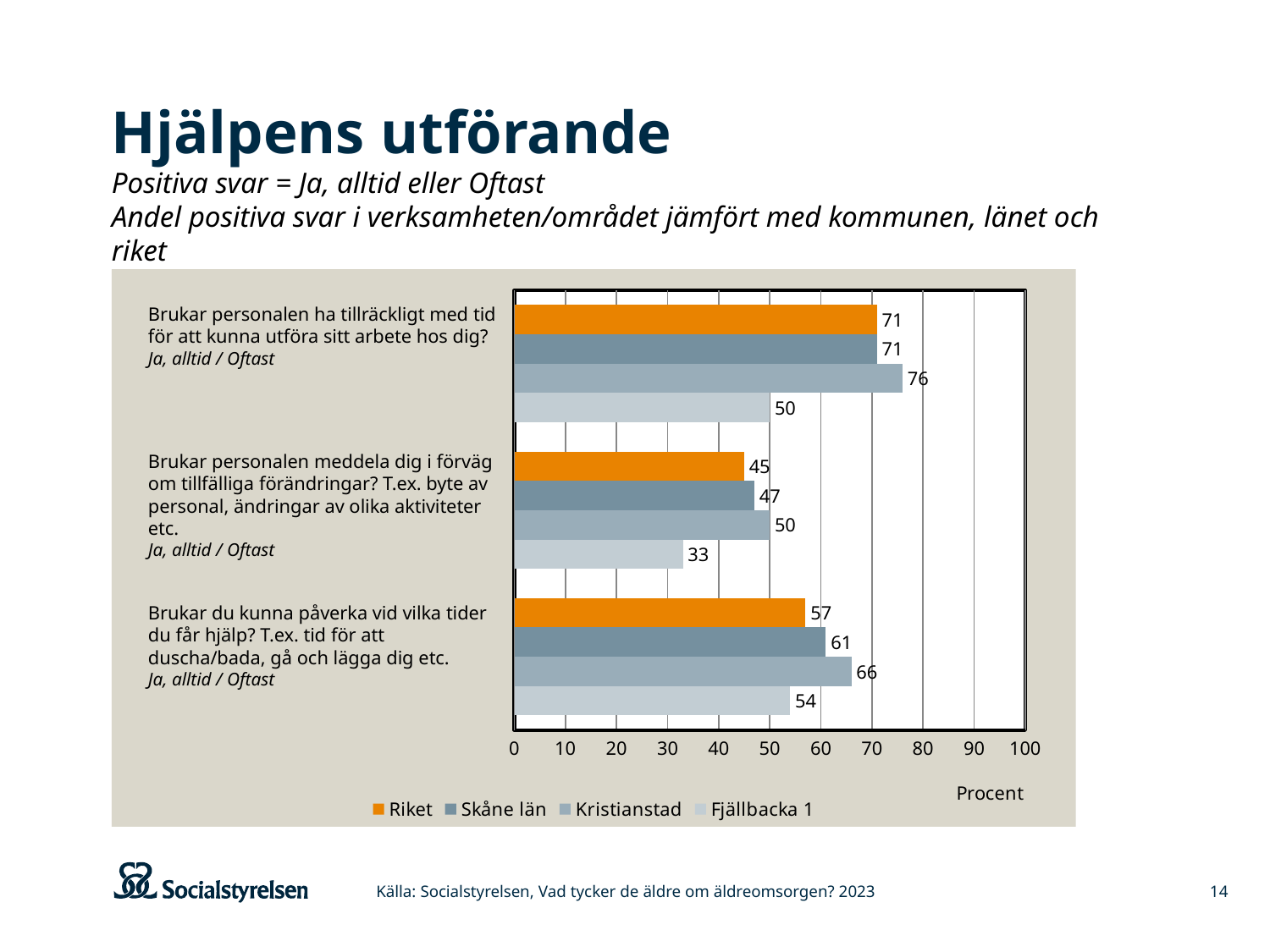
Which series has the lowest value for the question "Brukar personalen meddela dig i förväg om tillfälliga förändringar?"? Fjällbacka 1 How many question categories are shown on the chart? 3 Which is larger for the question "Brukar du kunna påverka vid vilka tider du får hjälp?": Skåne län or Fjällbacka 1? Skåne län How many series does the legend list? 4 What is the difference between Kristianstad and Fjällbacka 1 for the question "Brukar personalen ha tillräckligt med tid för att kunna utföra sitt arbete hos dig?"? 26 Is the value for Fjällbacka 1 for the question "Brukar personalen meddela dig i förväg om tillfälliga förändringar?" greater or less than 40? less Which series has the highest value for the question "Brukar personalen ha tillräckligt med tid för att kunna utföra sitt arbete hos dig?"? Kristianstad What is the value for Fjällbacka 1 for the question "Brukar personalen ha tillräckligt med tid för att kunna utföra sitt arbete hos dig?"? 50 What is the value for Riket for the question "Brukar personalen meddela dig i förväg om tillfälliga förändringar?"? 45 What is the value for Kristianstad for the question "Brukar du kunna påverka vid vilka tider du får hjälp?"? 66 What kind of chart is shown on the slide? Bar chart What unit is shown on the x axis of the chart? Procent